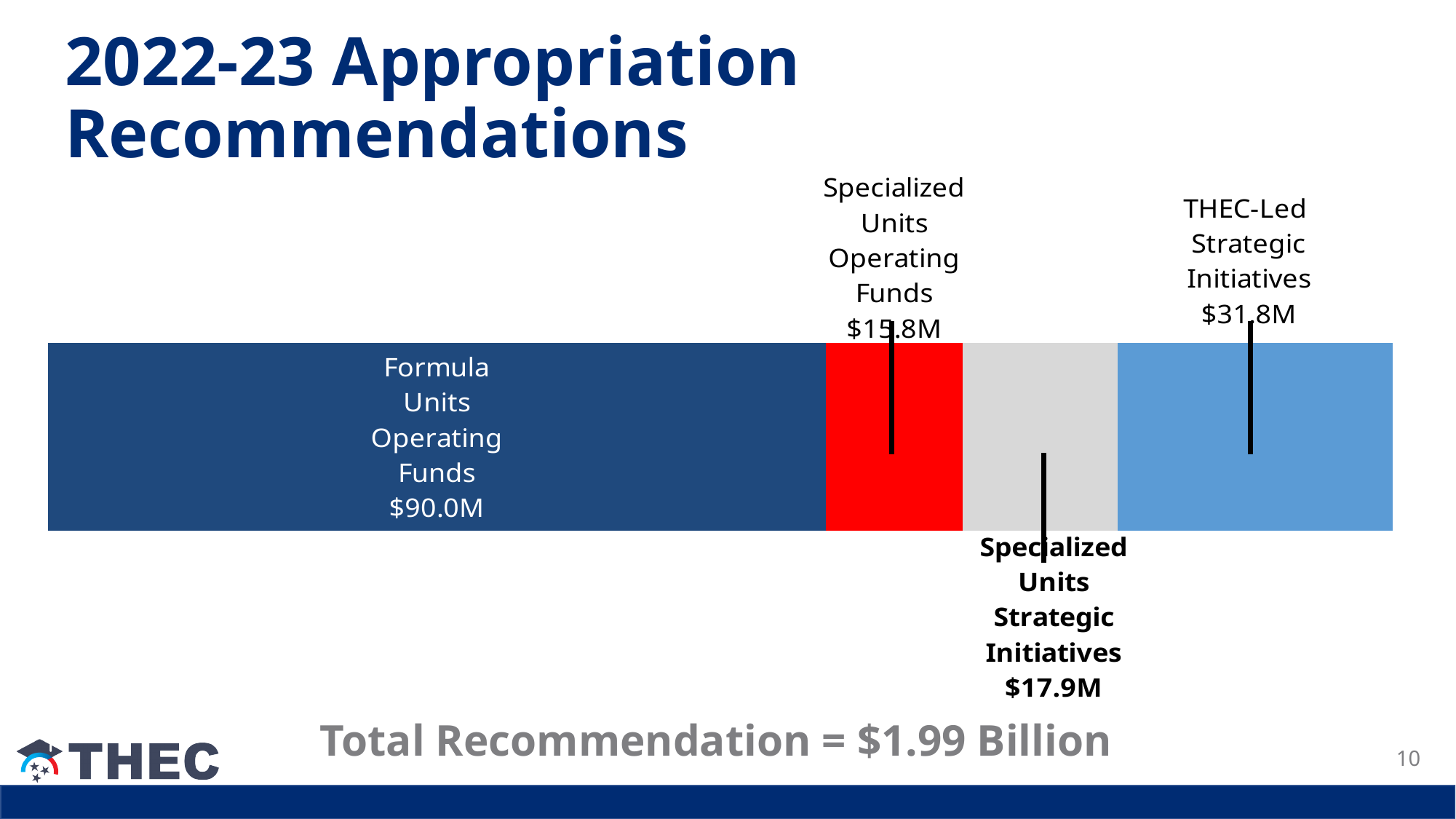
What kind of chart is shown on the slide? bar chart What is the value for Formula Units Operating Funds? $90.0M How many segments make up the bar? 4 What colour is the Specialized Units Operating Funds segment? red What total recommendation is stated below the chart? $1.99 Billion Which segment of the bar has the lowest value? Specialized Units Operating Funds What is the value for THEC-Led Strategic Initiatives? $31.8M Which is larger, THEC-Led Strategic Initiatives or Specialized Units Strategic Initiatives? THEC-Led Strategic Initiatives Which segment of the bar has the highest value? Formula Units Operating Funds What is the difference between Formula Units Operating Funds and THEC-Led Strategic Initiatives? $58.2M What is the value for Specialized Units Strategic Initiatives? $17.9M What is the difference between THEC-Led Strategic Initiatives and Specialized Units Strategic Initiatives? $13.9M